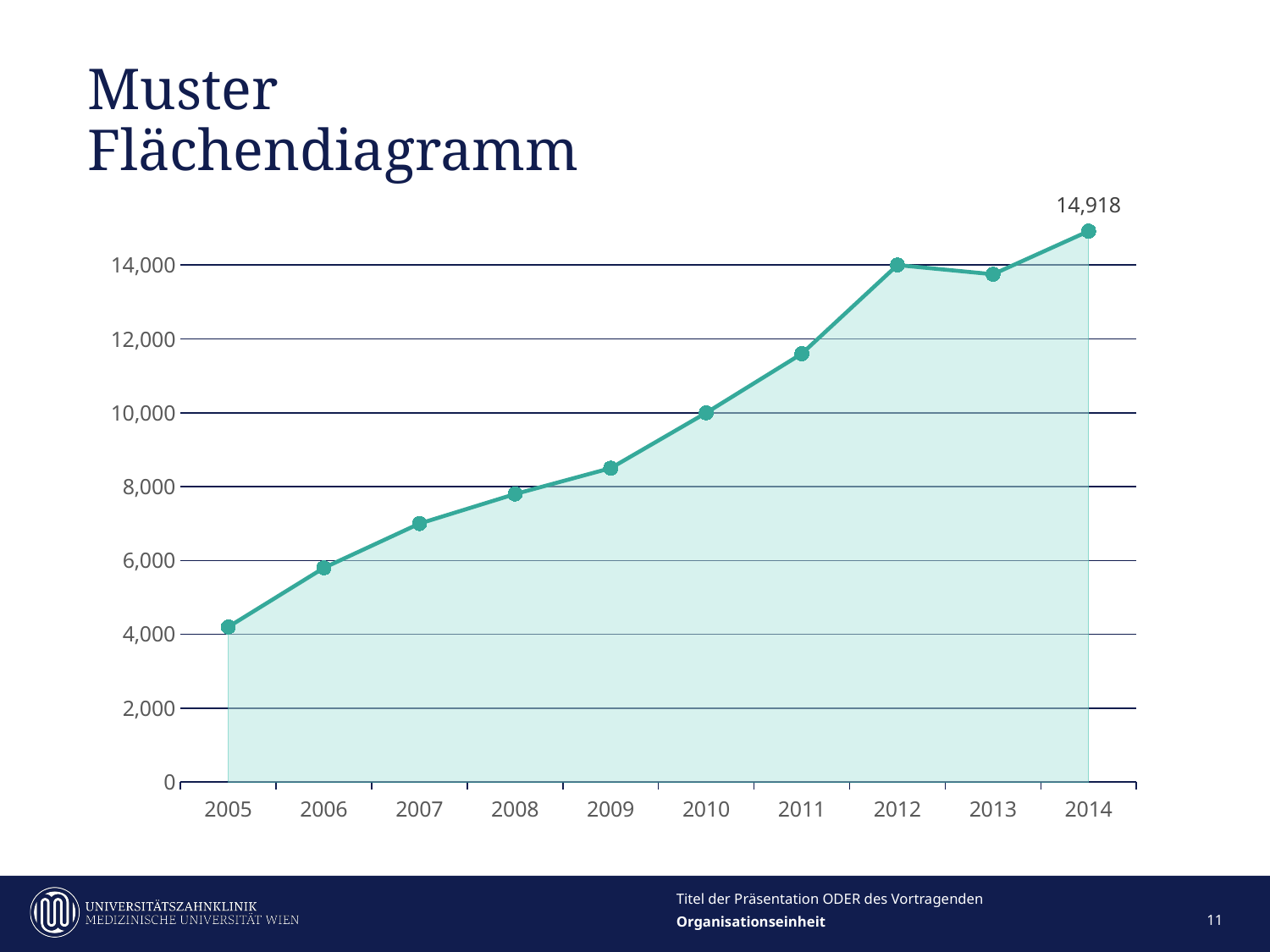
Which year has the lowest value? 2005 Which year has the larger value, 2006 or 2007? 2007 What kind of chart is shown on the slide? Area chart Is the value for 2009 greater or less than 10,000? less Which year has the larger value, 2012 or 2013? 2012 Is the value for 2005 greater or less than 6,000? less Which year has the highest value? 2014 Do the values generally rise or fall from 2005 to 2014? Rise How many years are plotted on the x axis? 10 What is the title of the slide containing the chart? Muster Flächendiagramm Is the value for 2011 greater or less than 10,000? greater What is the value for 2014? 14,918